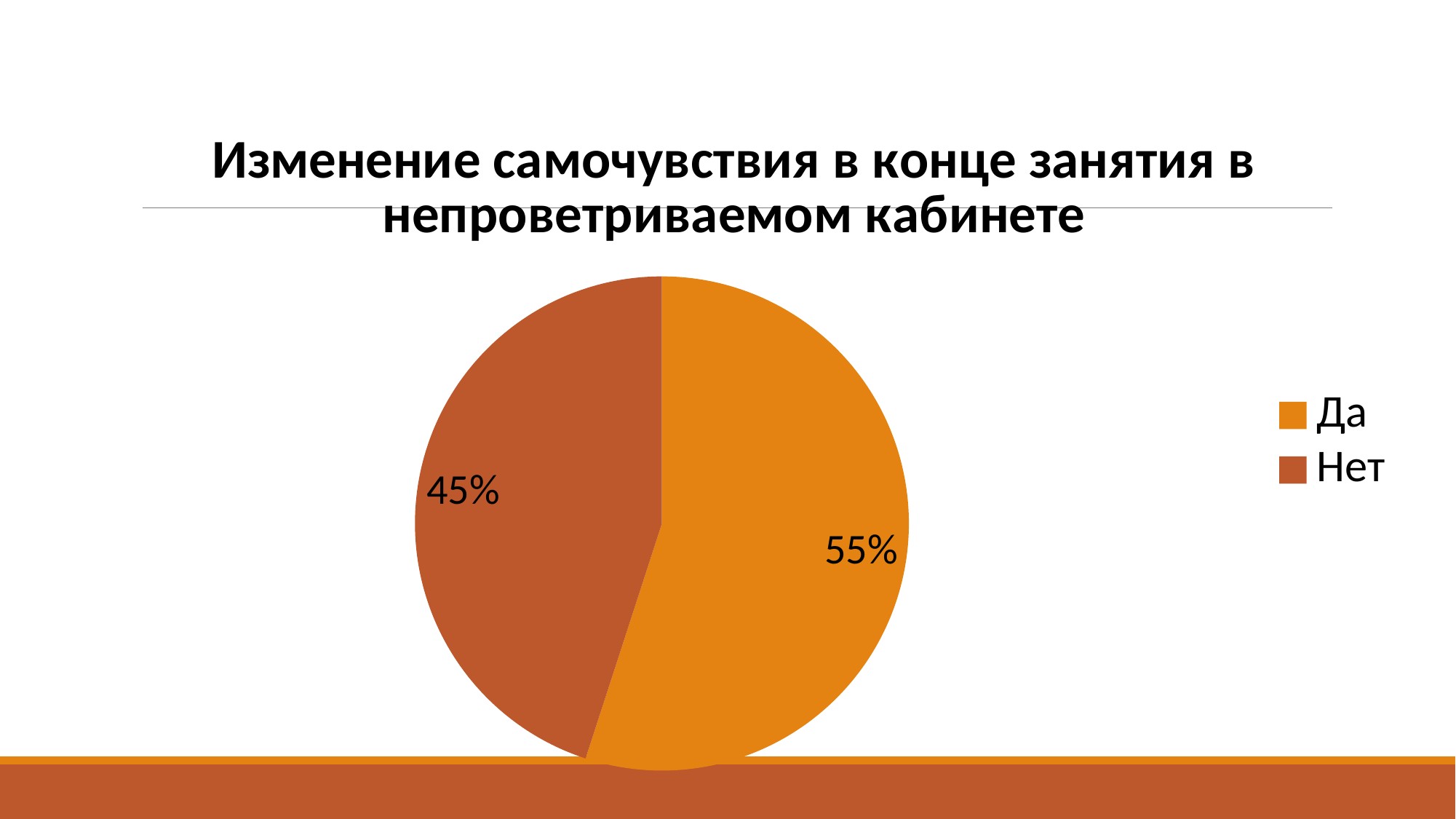
What share of the pie does the "Да" slice represent? 55% Which is larger, the "Да" slice or the "Нет" slice? Да Is the share for "Нет" greater or less than 50%? less How many slices does the pie chart have? 2 Which legend entry is shown in the lighter orange colour? Да What is the title of the chart? Изменение самочувствия в конце занятия в непроветриваемом кабинете What kind of chart is shown on the slide? Pie chart How many entries does the legend list? 2 Which slice is the largest in the pie chart? Да Which slice is the smallest in the pie chart? Нет What is the difference in percentage points between the "Да" and "Нет" slices? 10% What share of the pie does the "Нет" slice represent? 45%